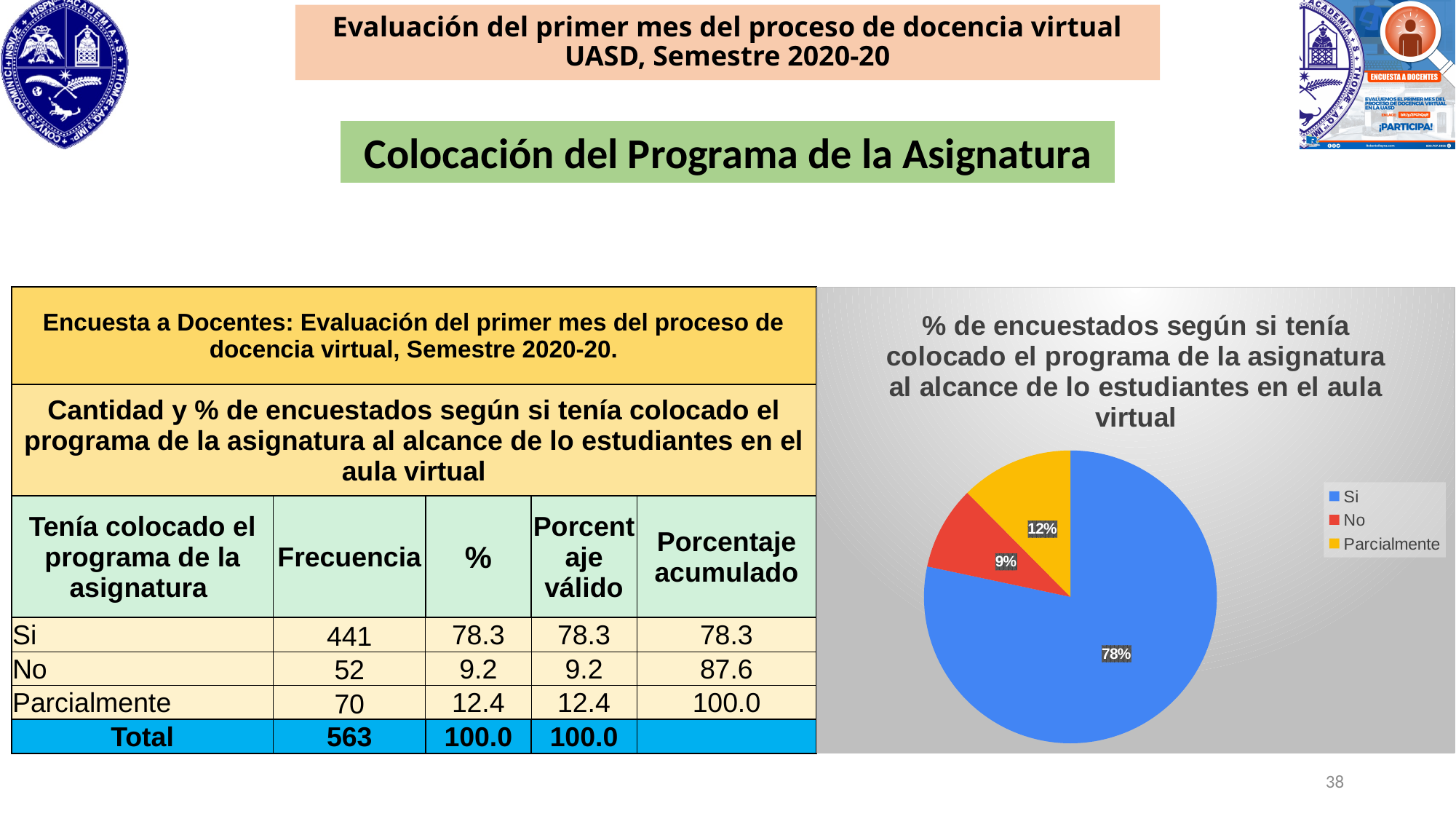
Which category has the smallest slice in the pie chart? No What colour is the "Parcialmente" slice in the pie chart? yellow Which category has the largest slice in the pie chart? Si What colour is the "Si" slice in the pie chart? blue What percentage does the pie chart show for "Si"? 78% What kind of chart is shown on the slide? pie chart How many slices does the pie chart have? 3 What percentage does the pie chart show for "Parcialmente"? 12% How many entries does the pie chart legend list? 3 What is the difference in percentage points between the "Si" slice and the "Parcialmente" slice in the pie chart? 66 What percentage does the pie chart show for "No"? 9% Which slice is larger in the pie chart, "No" or "Parcialmente"? Parcialmente